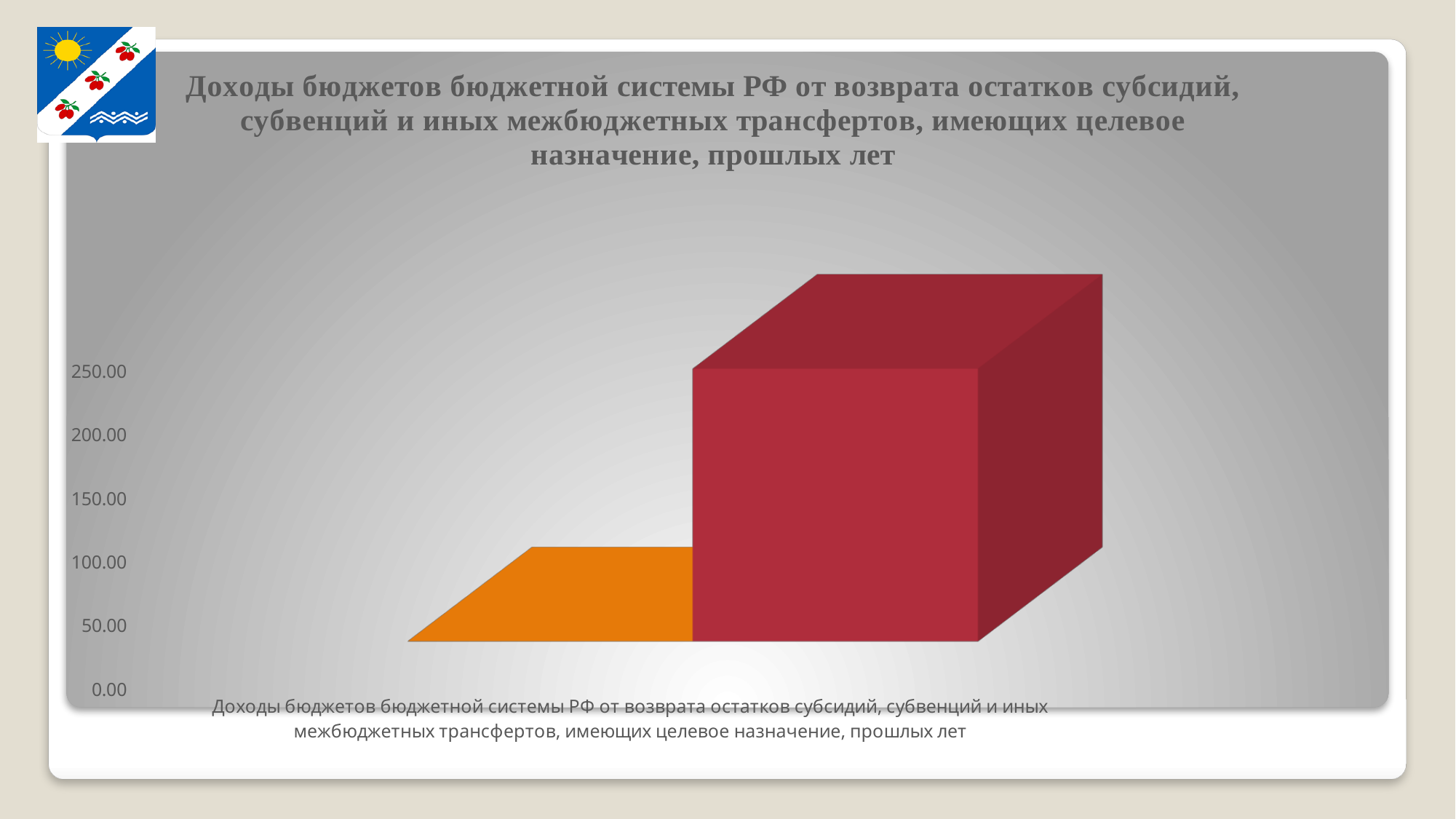
What is the title of the chart? Доходы бюджетов бюджетной системы РФ от возврата остатков субсидий, субвенций и иных межбюджетных трансфертов, имеющих целевое назначение, прошлых лет What kind of chart is shown on the slide? bar chart Which colour bar has the highest value in the chart? red Is the value of the orange bar greater or less than 50? less Which bar is taller, the red bar or the orange bar? the red bar What is the highest tick value shown on the vertical axis of the chart? 250.00 Is the value of the red bar greater or less than 100? greater How many categories are shown on the x axis of the chart? 1 How many bars are plotted in the chart? 2 Is the value of the red bar greater or less than 200? greater Which colour bar has the lowest value in the chart? orange